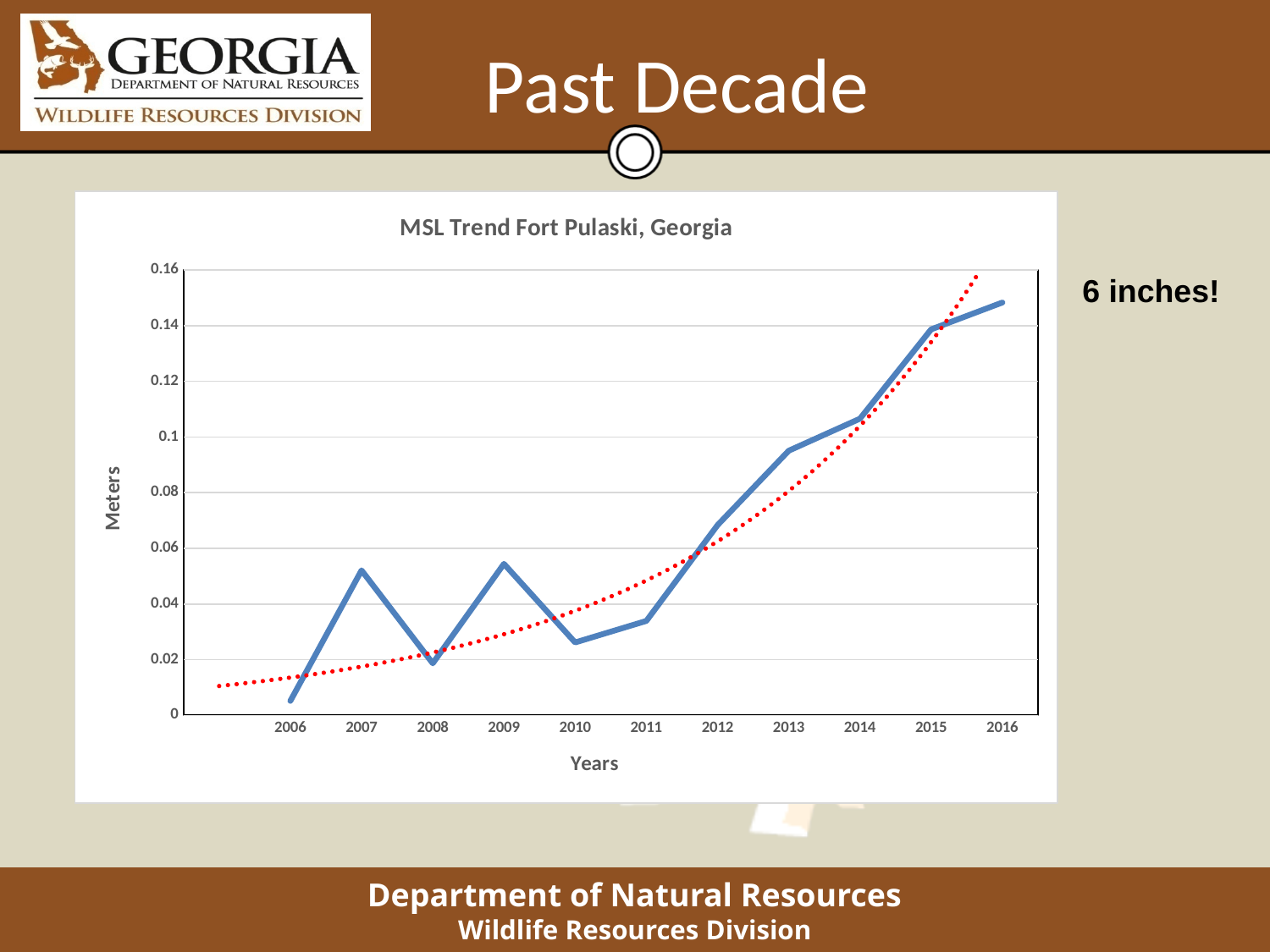
Which year has the highest value on the chart? 2016 What kind of chart is shown on the slide? line chart What is the title of the chart? MSL Trend Fort Pulaski, Georgia Which year has the larger value, 2007 or 2008? 2007 Is the value for 2011 greater or less than 0.04? less What is the label on the vertical axis of the chart? Meters Is the value for 2013 greater or less than 0.08? greater How many years are plotted on the x axis of the chart? 11 Which year has the lowest value on the chart? 2006 Overall, do the values rise or fall from 2006 to 2016? rise Is the value for 2006 greater or less than 0.02? less